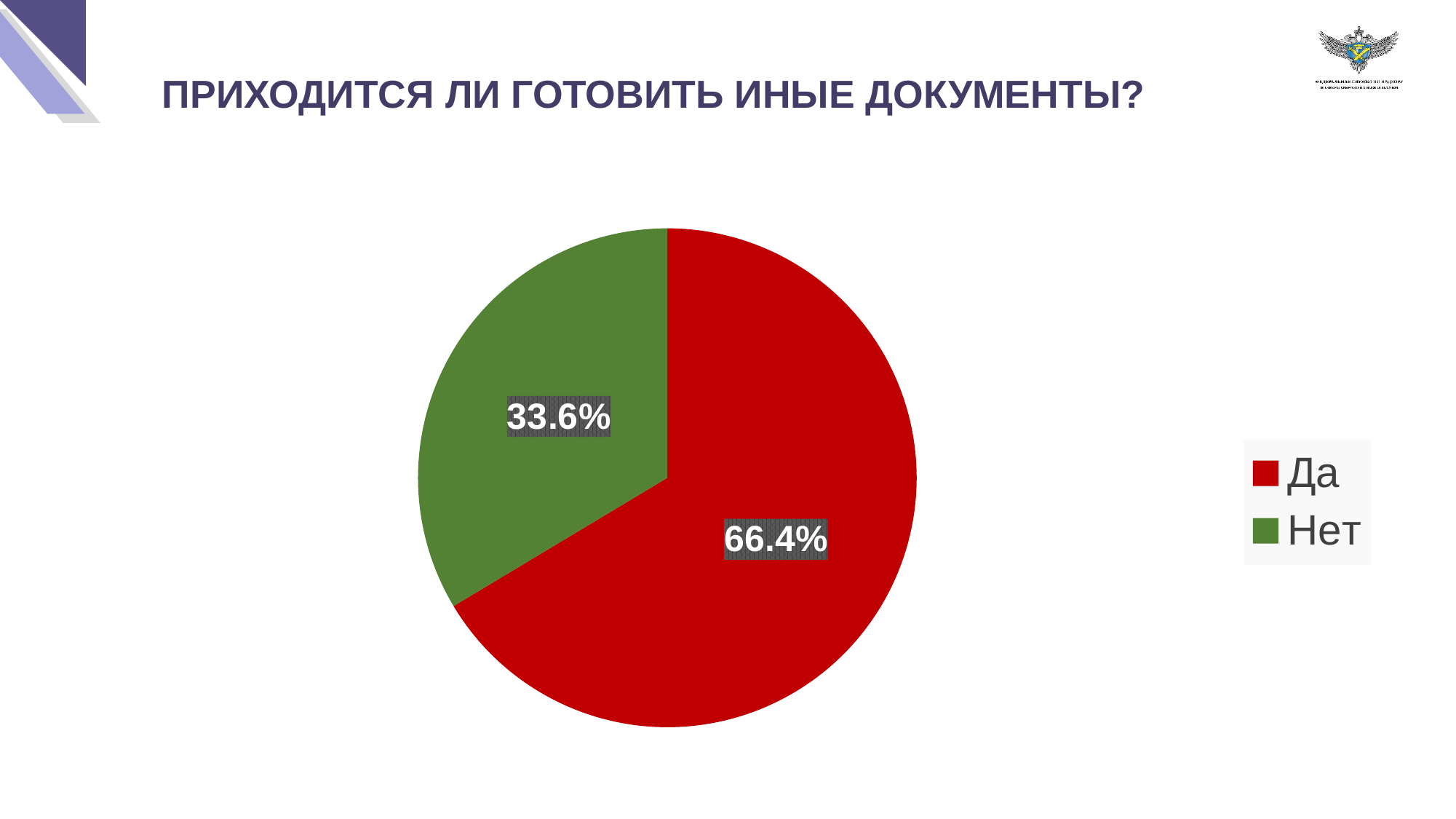
What kind of chart is shown on the slide? pie chart What is the title of the slide above the chart? ПРИХОДИТСЯ ЛИ ГОТОВИТЬ ИНЫЕ ДОКУМЕНТЫ? What is the value for "Нет"? 33.6% Which category has the largest share of the pie? Да How many slices does the pie chart have? 2 What is the value for "Да"? 66.4% What share of the pie does the "Нет" slice represent? 33.6% What colour is the "Да" slice? red What is the difference between the shares for "Да" and "Нет"? 32.8% Which category has the smallest share of the pie? Нет How many entries does the legend list? 2 Which is larger, the share for "Да" or the share for "Нет"? Да